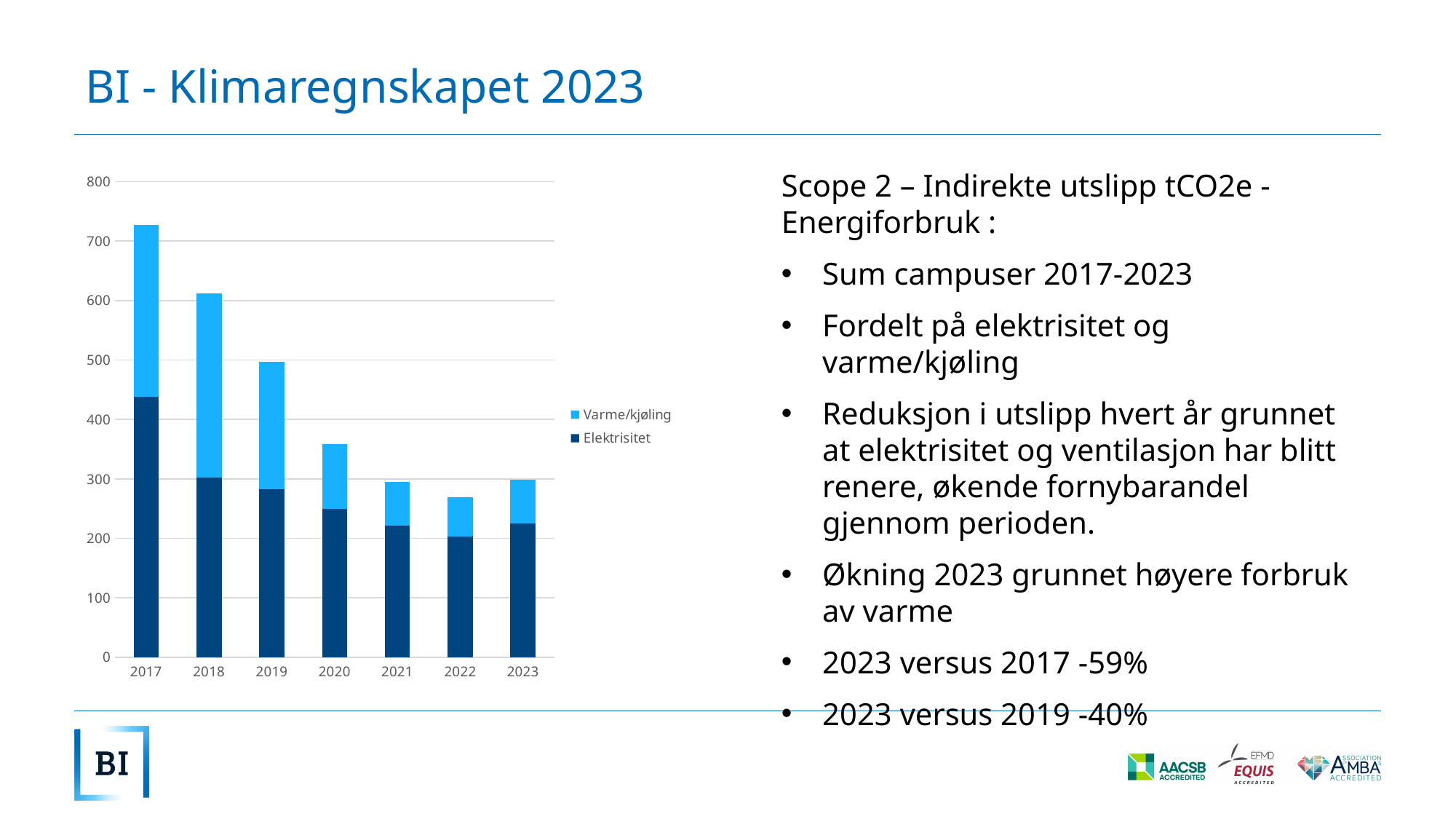
Is the Elektrisitet value for 2017 greater or less than 400? greater Which series is shown in the darker blue colour in the chart? Elektrisitet Is the Elektrisitet value for 2021 greater or less than 300? less Which year has the lowest total bar in the chart? 2022 What kind of chart is shown on the slide? Stacked bar chart Which year has the larger total bar, 2018 or 2019? 2018 How many years are shown on the x axis of the chart? 7 Do the total bars rise or fall from 2017 to 2022? fall Is the total bar for 2017 greater or less than 600? greater How many series does the chart legend list? 2 Which year has the highest total bar in the chart? 2017